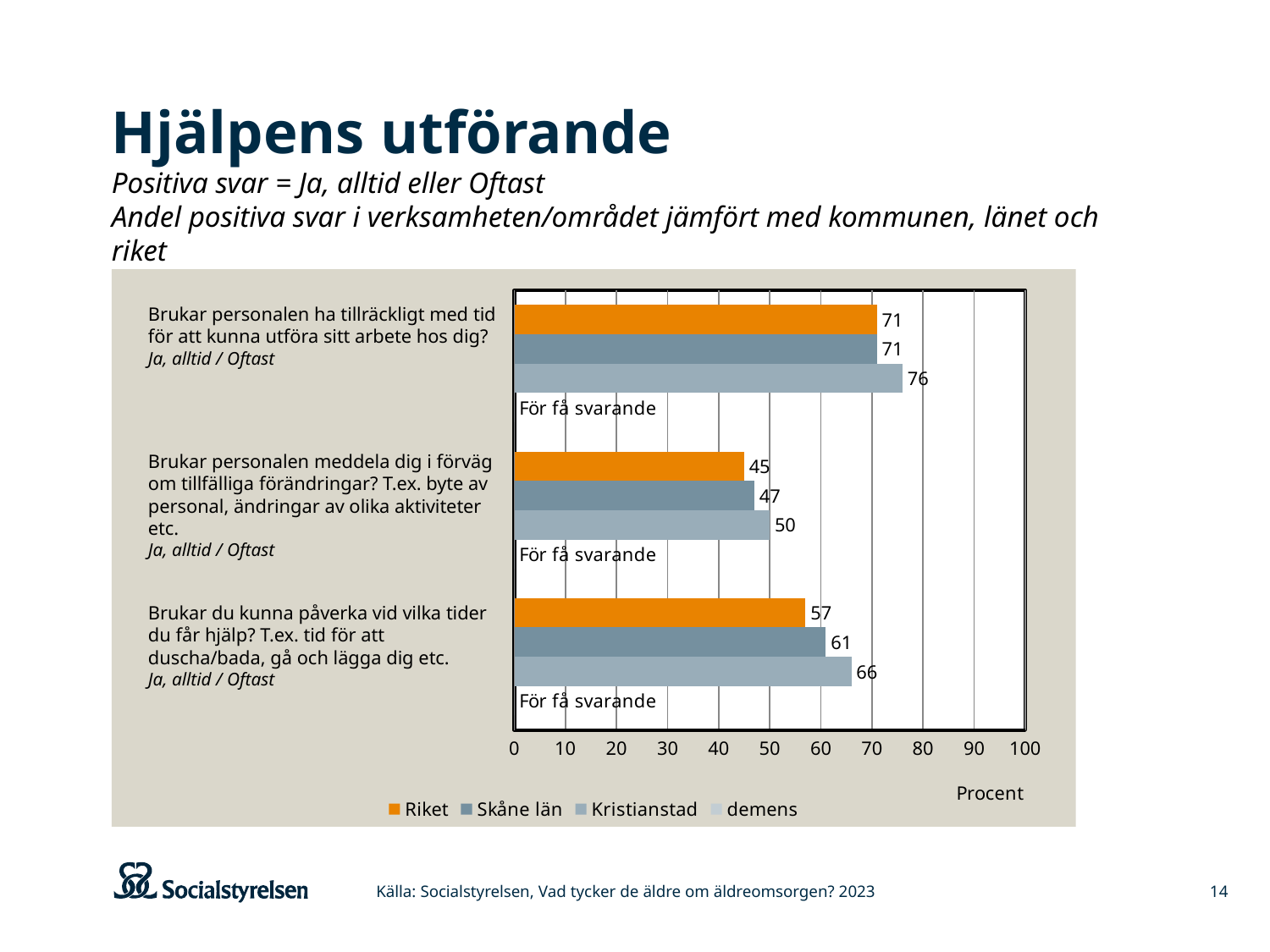
On the question 'Brukar personalen meddela dig i förväg om tillfälliga förändringar?', which is larger, Kristianstad or Skåne län? Kristianstad What is the value for Riket on the question 'Brukar personalen meddela dig i förväg om tillfälliga förändringar?' 45 What kind of chart is shown on the slide? bar chart What is the difference between Kristianstad and Riket on the question 'Brukar du kunna påverka vid vilka tider du får hjälp?' 9 What is the label on the horizontal axis? Procent How many series does the legend list? 4 What is the value for Skåne län on the question 'Brukar du kunna påverka vid vilka tider du får hjälp?' 61 What is shown for the demens series on each question instead of a bar? För få svarande What is the value for Kristianstad on the question 'Brukar personalen ha tillräckligt med tid för att kunna utföra sitt arbete hos dig?' 76 Which question has the lowest value for Riket? Brukar personalen meddela dig i förväg om tillfälliga förändringar? Which question has the highest value for Kristianstad? Brukar personalen ha tillräckligt med tid för att kunna utföra sitt arbete hos dig? How many question categories are shown on the chart? 3